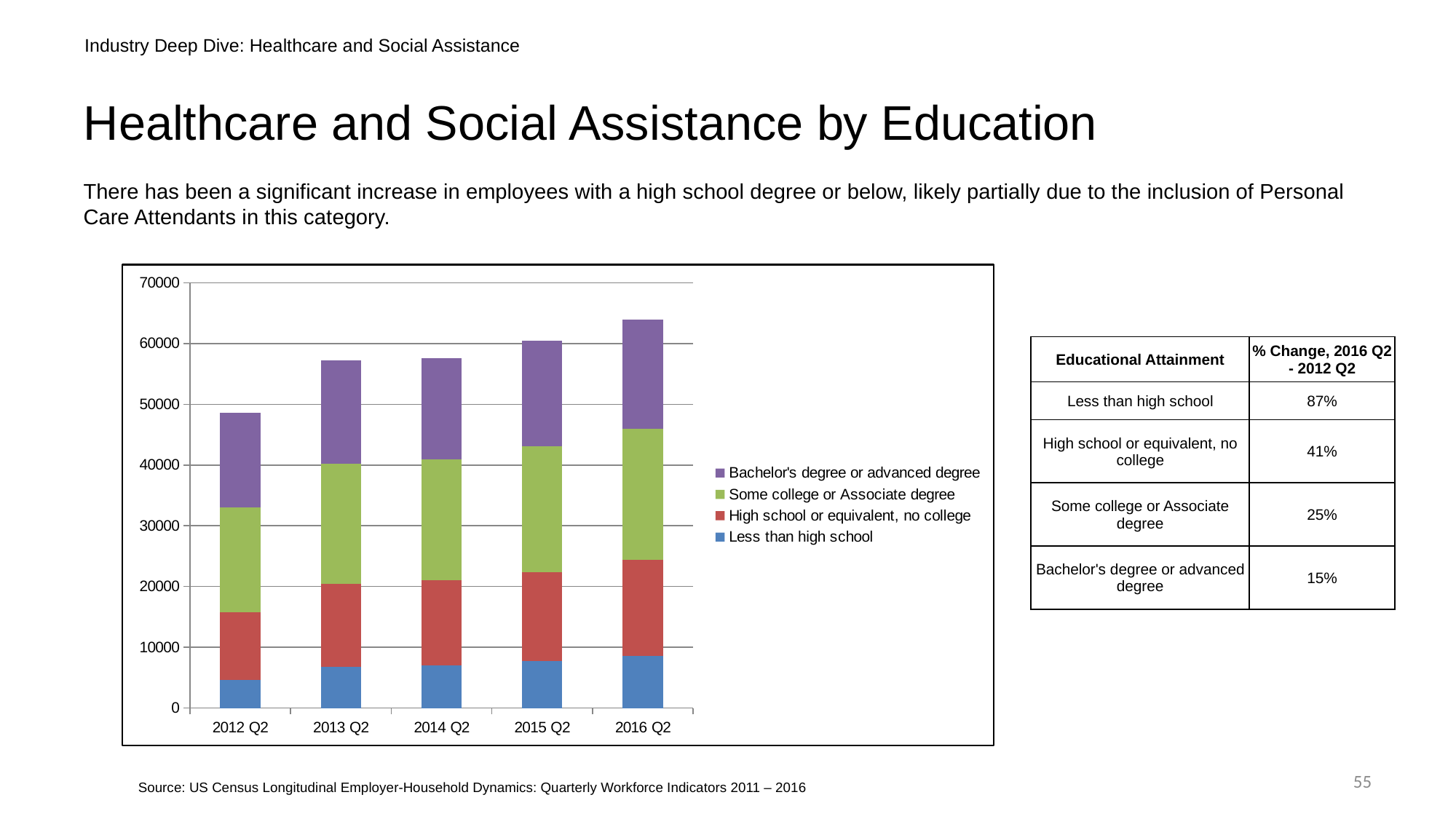
Which is larger, the total bar for 2016 Q2 or the total bar for 2012 Q2? 2016 Q2 Do the total bar heights rise or fall from 2012 Q2 to 2016 Q2? Rise Is the total stacked bar for 2012 Q2 greater or less than 50000? less Which period has the tallest stacked bar in the chart? 2016 Q2 How many time periods (bars) are shown on the x axis of the chart? 5 Which colour represents 'Less than high school' in the chart? Blue How many series does the chart's legend list? 4 Which period has the shortest stacked bar in the chart? 2012 Q2 Is the total stacked bar for 2016 Q2 greater or less than 60000? greater Is the 'Less than high school' segment for 2016 Q2 greater or less than 10000? less What kind of chart is shown on the slide? Stacked bar chart